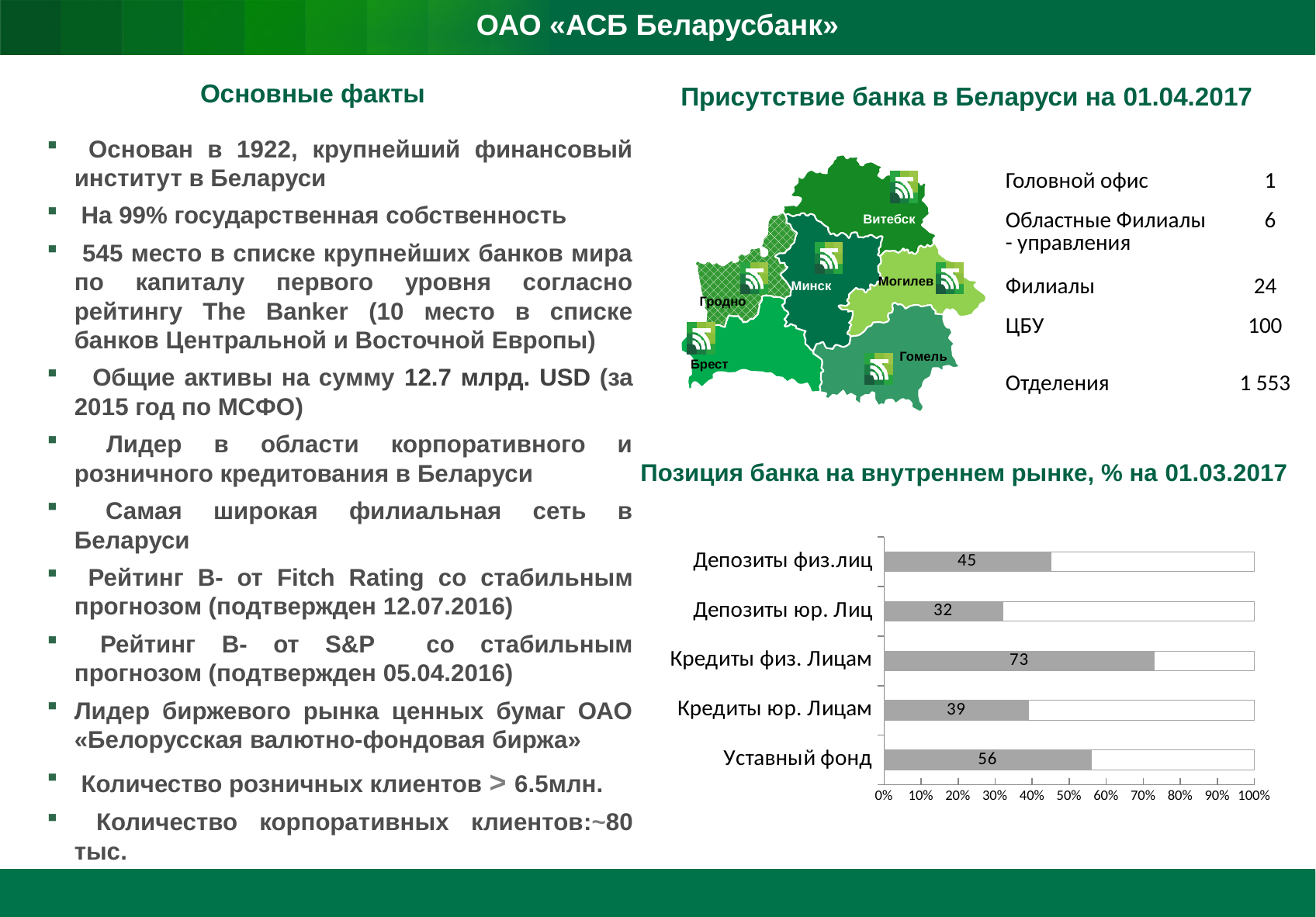
What is the value for Кредиты физ. Лицам in the chart? 73 Which category has the lowest value in the chart? Депозиты юр. Лиц What is the value for Депозиты физ.лиц in the chart? 45 What is the title of the chart on the slide? Позиция банка на внутреннем рынке, % на 01.03.2017 How many categories are shown in the chart? 5 What kind of chart is shown on the slide? bar chart Which is larger: the value for Депозиты физ.лиц or the value for Кредиты юр. Лицам? Депозиты физ.лиц What is the value for Уставный фонд in the chart? 56 What is the difference between the values for Кредиты физ. Лицам and Кредиты юр. Лицам? 34 Which category has the highest value in the chart? Кредиты физ. Лицам Is the value for Уставный фонд greater or less than 50%? greater What is the value for Депозиты юр. Лиц in the chart? 32